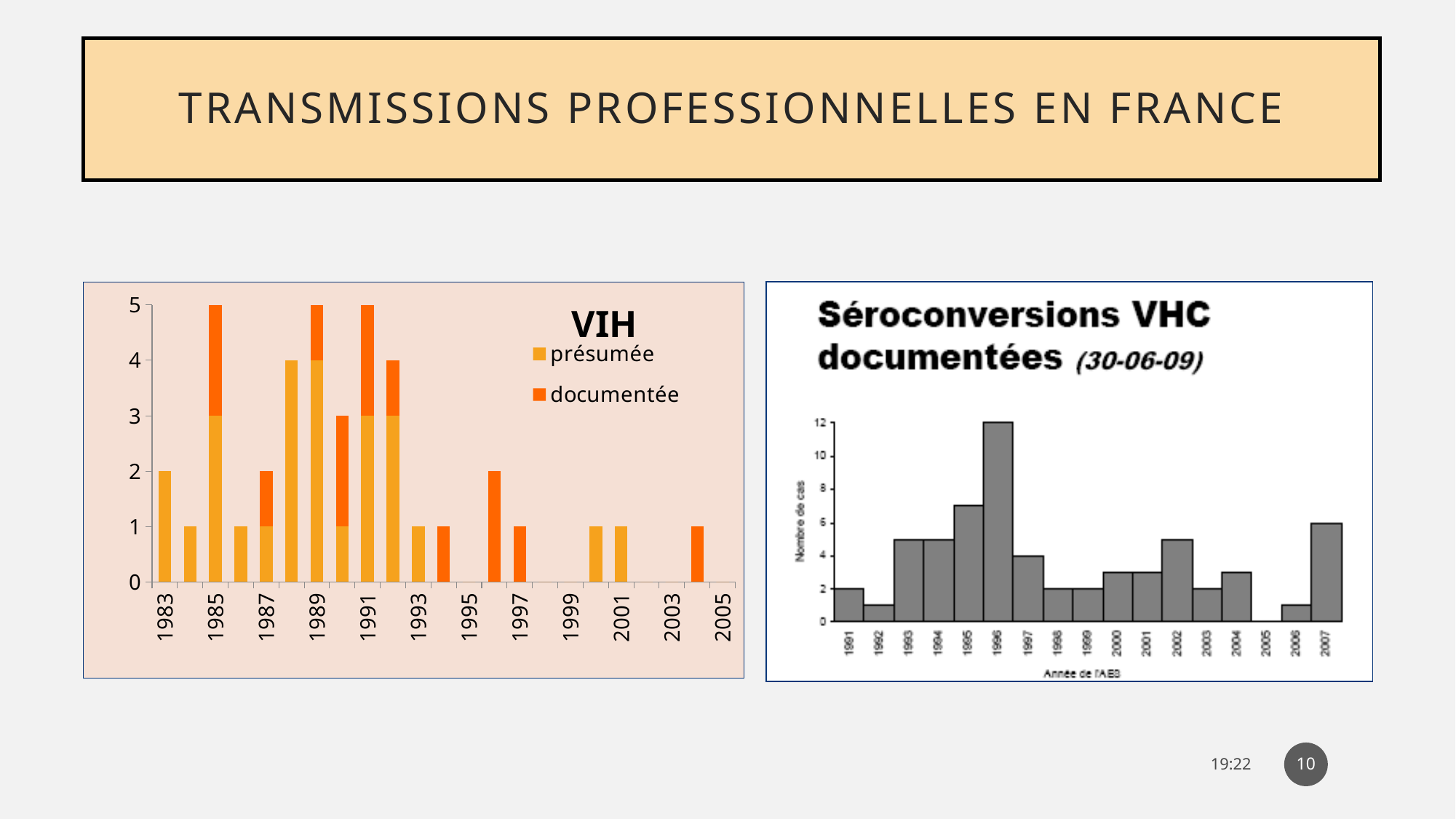
In the VIH chart, which series is shown in the darker red-orange colour? documentée In the Séroconversions VHC documentées chart, which year has more cases, 2002 or 2003? 2002 In the VIH chart, what is the value of the présumée series for 1983? 2 How many series does the legend of the VIH chart list? 2 In the Séroconversions VHC documentées chart, what is the label of the y axis? Nombre de cas In the Séroconversions VHC documentées chart, which year has the highest number of cases? 1996 In the VIH chart, what is the value of the documentée series for 1997? 1 In the Séroconversions VHC documentées chart, how many cases are shown for 1996? 12 In the VIH chart, what is the total height of the stacked bar for 1985? 5 What kind of chart is the VIH chart on the left? bar chart In the Séroconversions VHC documentées chart, how many cases are shown for 2007? 6